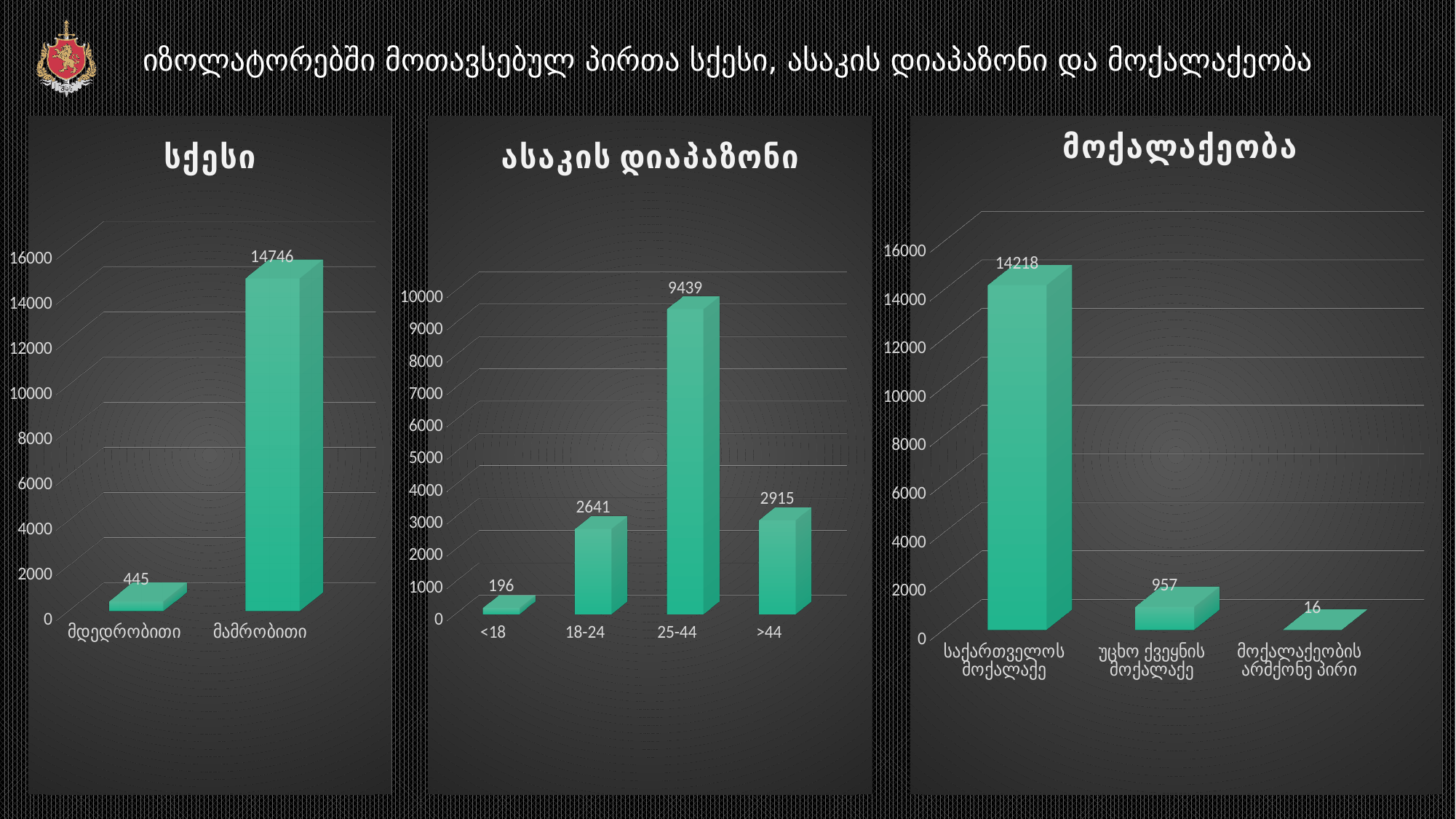
In the middle chart titled "ასაკის დიაპაზონი", what is the difference between the values for ">44" and "18-24"? 274 In the right chart titled "მოქალაქეობა", which category has the highest value? საქართველოს მოქალაქე In the left chart titled "სქესი", what is the value for "მდედრობითი"? 445 In the right chart titled "მოქალაქეობა", what is the value for "უცხო ქვეყნის მოქალაქე"? 957 What type of chart is the right chart titled "მოქალაქეობა"? Bar chart In the right chart titled "მოქალაქეობა", what is the value for "მოქალაქეობის არმქონე პირი"? 16 In the middle chart titled "ასაკის დიაპაზონი", how many age groups are shown? 4 In the middle chart titled "ასაკის დიაპაზონი", which age group has the lowest value? <18 In the middle chart titled "ასაკის დიაპაზონი", which is larger: the value for "18-24" or the value for ">44"? >44 In the left chart titled "სქესი", what is the value for "მამრობითი"? 14746 In the middle chart titled "ასაკის დიაპაზონი", what is the value for the "25-44" age group? 9439 In the left chart titled "სქესი", what is the difference between the values for "მამრობითი" and "მდედრობითი"? 14301